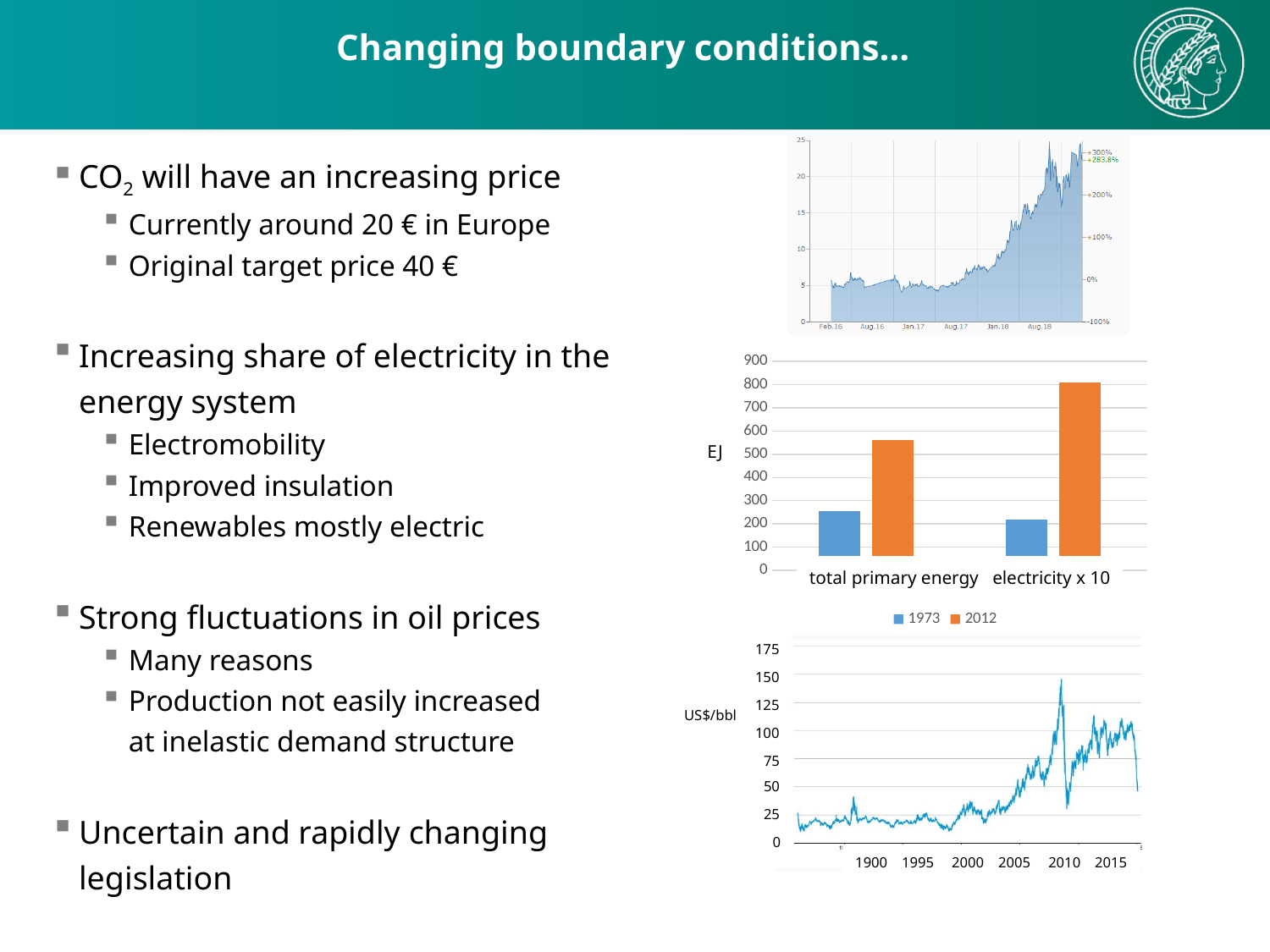
In the middle bar chart (EJ axis), which series has the taller bar for total primary energy, 1973 or 2012? 2012 In the middle bar chart (EJ axis), is the 2012 value for electricity x 10 greater or less than 700? greater In the middle bar chart (EJ axis), what unit label is shown on the vertical axis? EJ In the middle bar chart (EJ axis), how many categories are shown on the x axis? 2 In the middle bar chart (EJ axis), is the 1973 value for total primary energy greater or less than 300? less In the bottom line chart (US$/bbl), is the peak value around 2008 greater or less than 125? greater What kind of chart is the middle chart on the right side of the slide (the one with the EJ axis)? bar chart In the middle bar chart (EJ axis), which bar is the tallest overall? 2012 electricity x 10 In the middle bar chart (EJ axis), what are the two series named in the legend? 1973 and 2012 In the middle bar chart (EJ axis), how many series does the legend list? 2 What kind of chart is the bottom chart on the right side of the slide (the one with the US$/bbl axis)? line chart